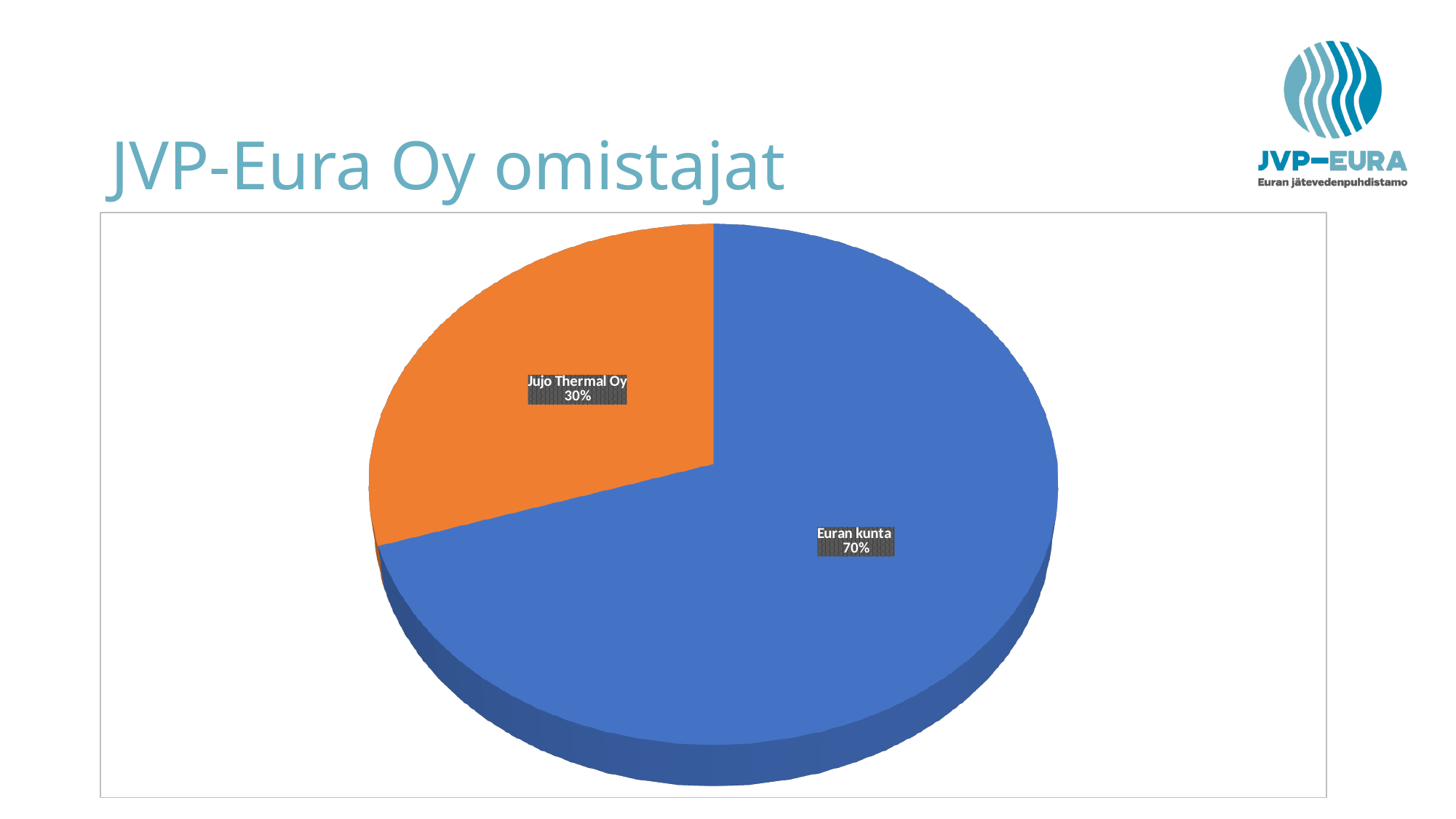
Which is larger, the Euran kunta slice or the Jujo Thermal Oy slice? Euran kunta What is the title of the slide containing the pie chart? JVP-Eura Oy omistajat What kind of chart is shown on the slide? Pie chart What is the difference in percentage points between the Euran kunta and Jujo Thermal Oy slices? 40 Which slice of the pie is the smallest? Jujo Thermal Oy Which slice of the pie is the largest? Euran kunta What colour is the Euran kunta slice? Blue How many slices does the pie chart have? 2 What share of the pie does Jujo Thermal Oy hold? 30% What share of the pie does Euran kunta hold? 70%